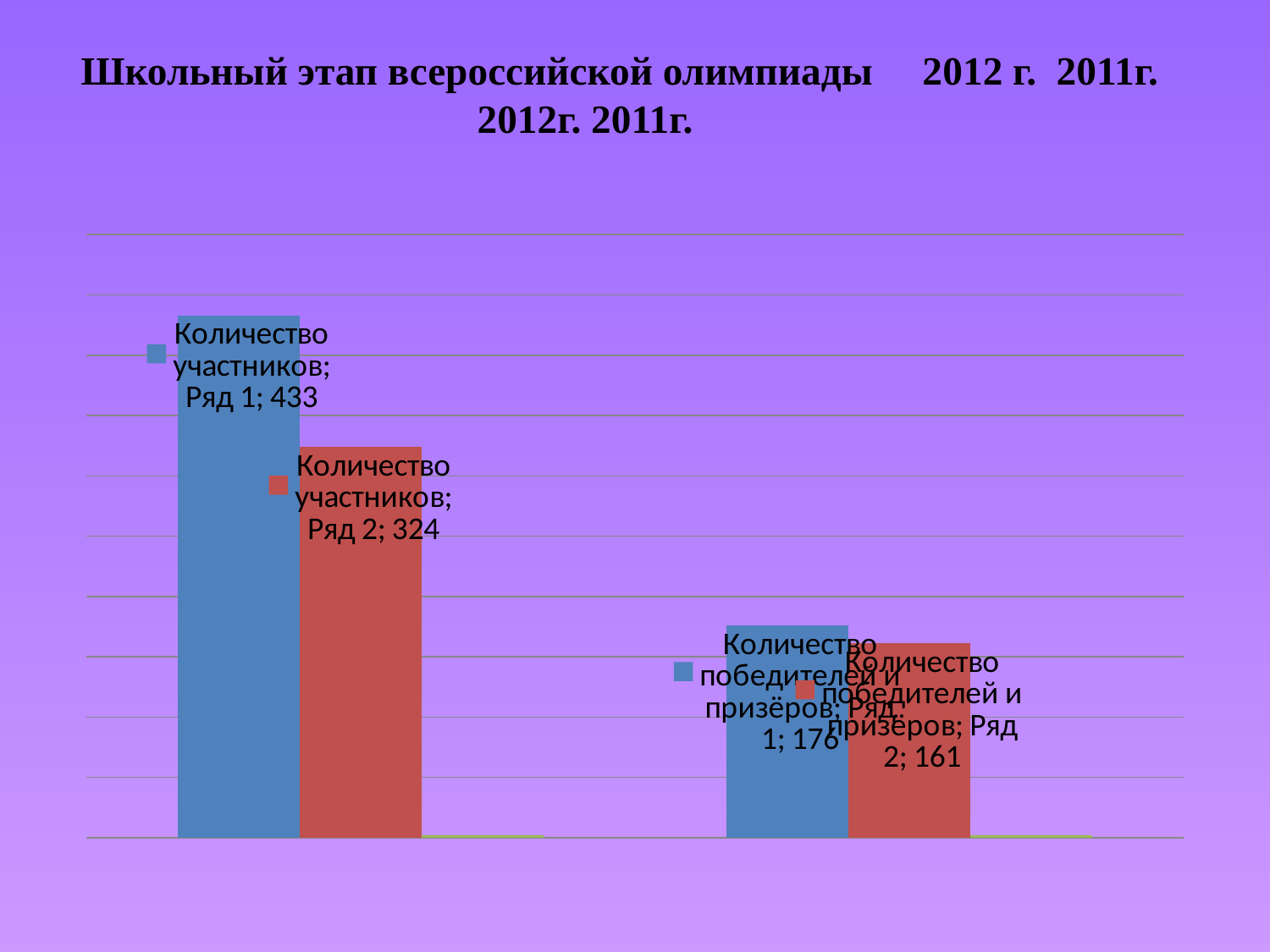
What colour are the bars for Ряд 2? Red Which is larger: Количество участников in Ряд 2 or Количество победителей и призёров in Ряд 1? Количество участников in Ряд 2 Which bar has the highest value on the chart? Количество участников, Ряд 1 How many categories are shown on the chart? 2 What kind of chart is shown on the slide? Bar chart What is the value for Количество участников in Ряд 2? 324 What is the value for Количество победителей и призёров in Ряд 1? 176 What is the difference between Ряд 1 and Ряд 2 for Количество участников? 109 What is the value for Количество участников in Ряд 1? 433 What is the difference between Ряд 1 and Ряд 2 for Количество победителей и призёров? 15 What is the value for Количество победителей и призёров in Ряд 2? 161